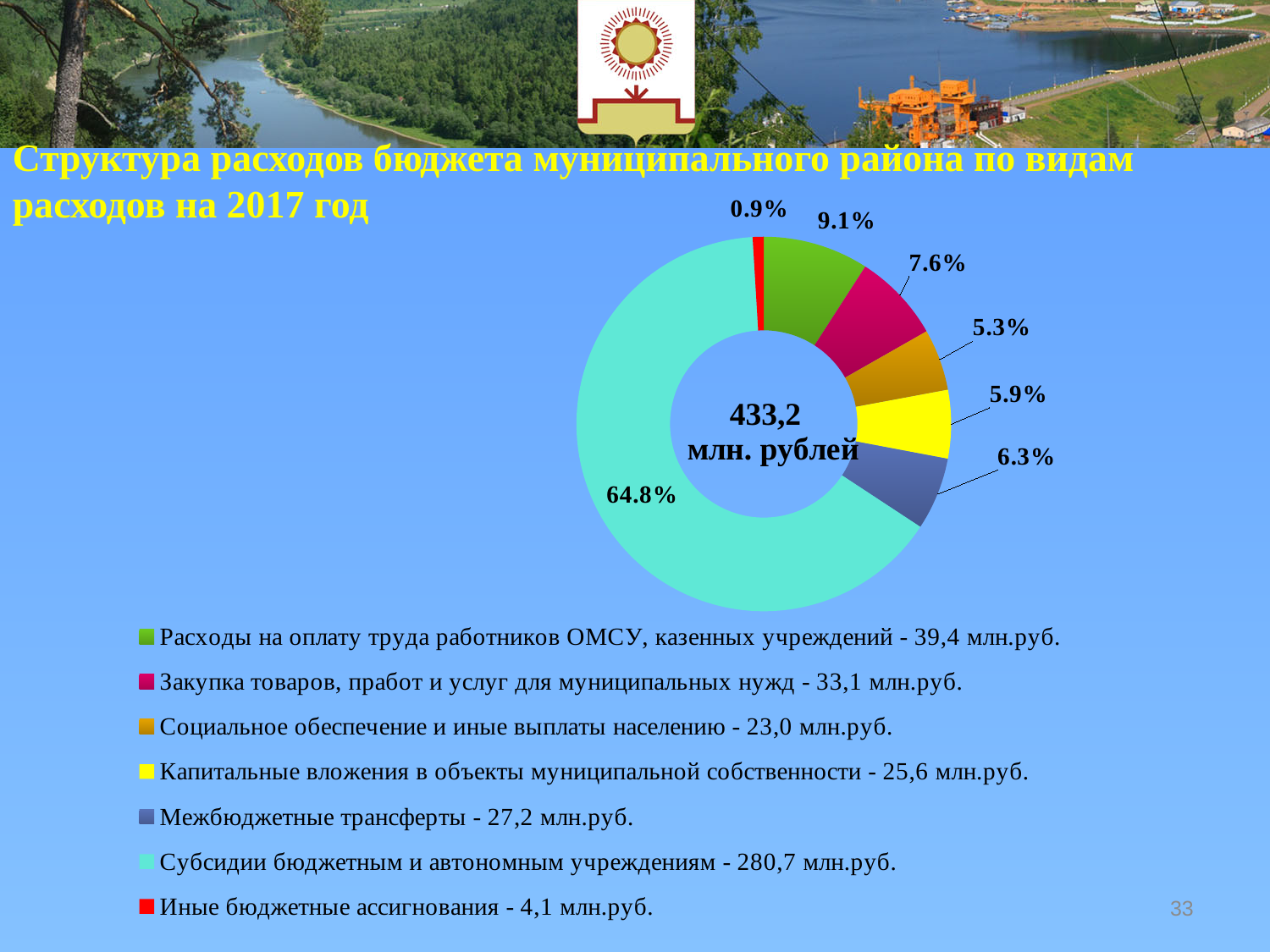
What kind of chart is shown on the slide? Doughnut (pie) chart What total amount is printed in the centre of the doughnut chart? 433,2 млн. рублей How many slices does the doughnut chart have? 7 Which category has the smallest slice in the chart? Иные бюджетные ассигнования What share of the chart is taken by 'Субсидии бюджетным и автономным учреждениям'? 64.8% Which is larger: the slice for 'Капитальные вложения в объекты муниципальной собственности' or the slice for 'Межбюджетные трансферты'? Межбюджетные трансферты How many entries does the legend list? 7 What is the difference in percentage points between the 'Закупка товаров, пработ и услуг для муниципальных нужд' slice (7.6%) and the 'Социальное обеспечение и иные выплаты населению' slice (5.3%)? 2.3 percentage points What share of the chart is taken by 'Расходы на оплату труда работников ОМСУ, казенных учреждений'? 9.1% What share of the chart is taken by 'Иные бюджетные ассигнования'? 0.9% Which category has the largest slice in the chart? Субсидии бюджетным и автономным учреждениям